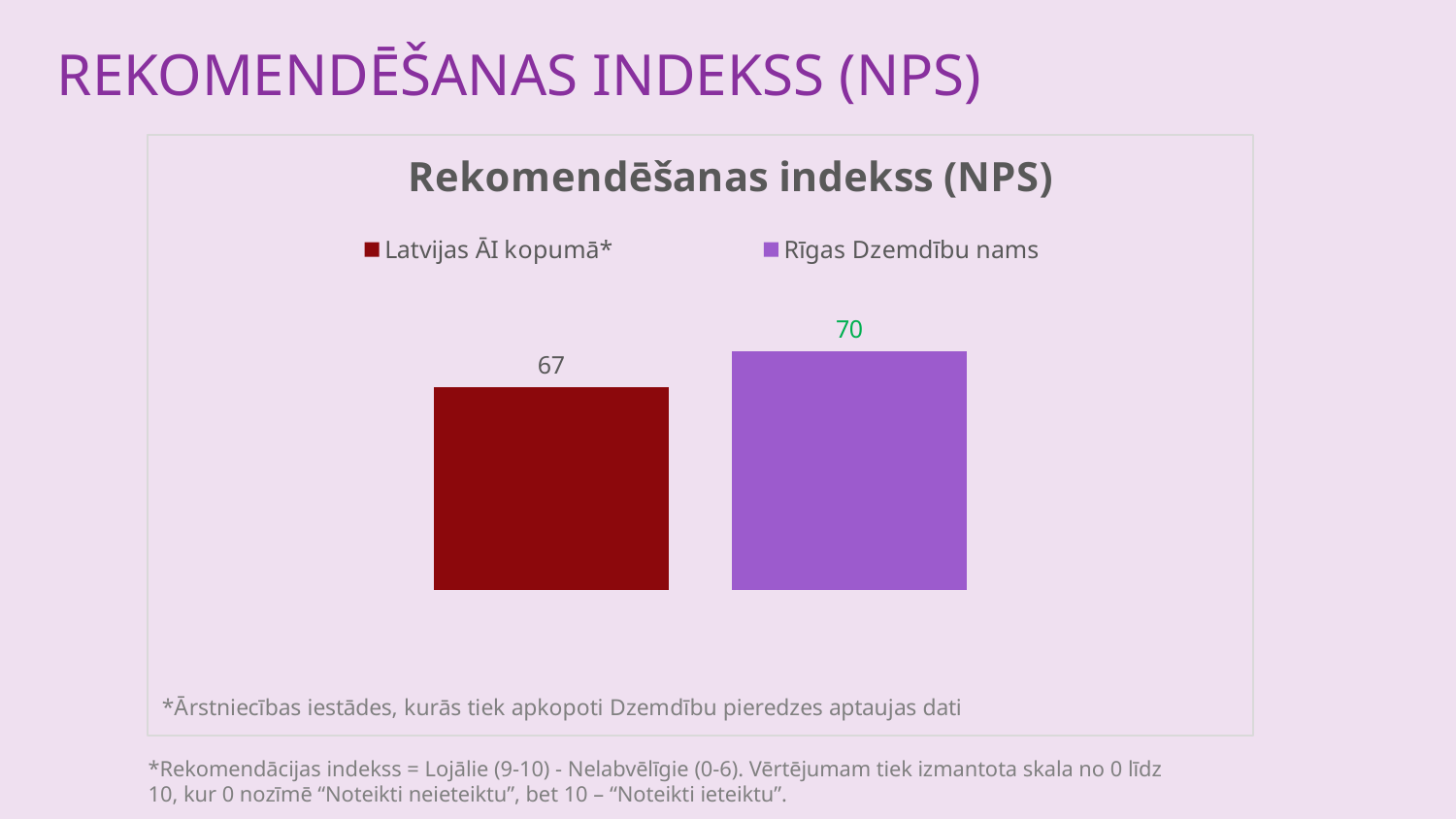
How many bars are plotted in the chart? 2 What kind of chart is shown on the slide? bar chart Is the NPS for Latvijas ĀI kopumā* larger or smaller than the NPS for Rīgas Dzemdību nams? smaller What is the title of the chart? Rekomendēšanas indekss (NPS) What is the difference between the NPS of Rīgas Dzemdību nams and Latvijas ĀI kopumā*? 3 What is the NPS value for Latvijas ĀI kopumā*? 67 What is the NPS value for Rīgas Dzemdību nams? 70 Which series has the lower NPS value? Latvijas ĀI kopumā* Which series has the higher NPS value? Rīgas Dzemdību nams How many series does the legend list? 2 What colour is the bar for Rīgas Dzemdību nams? purple